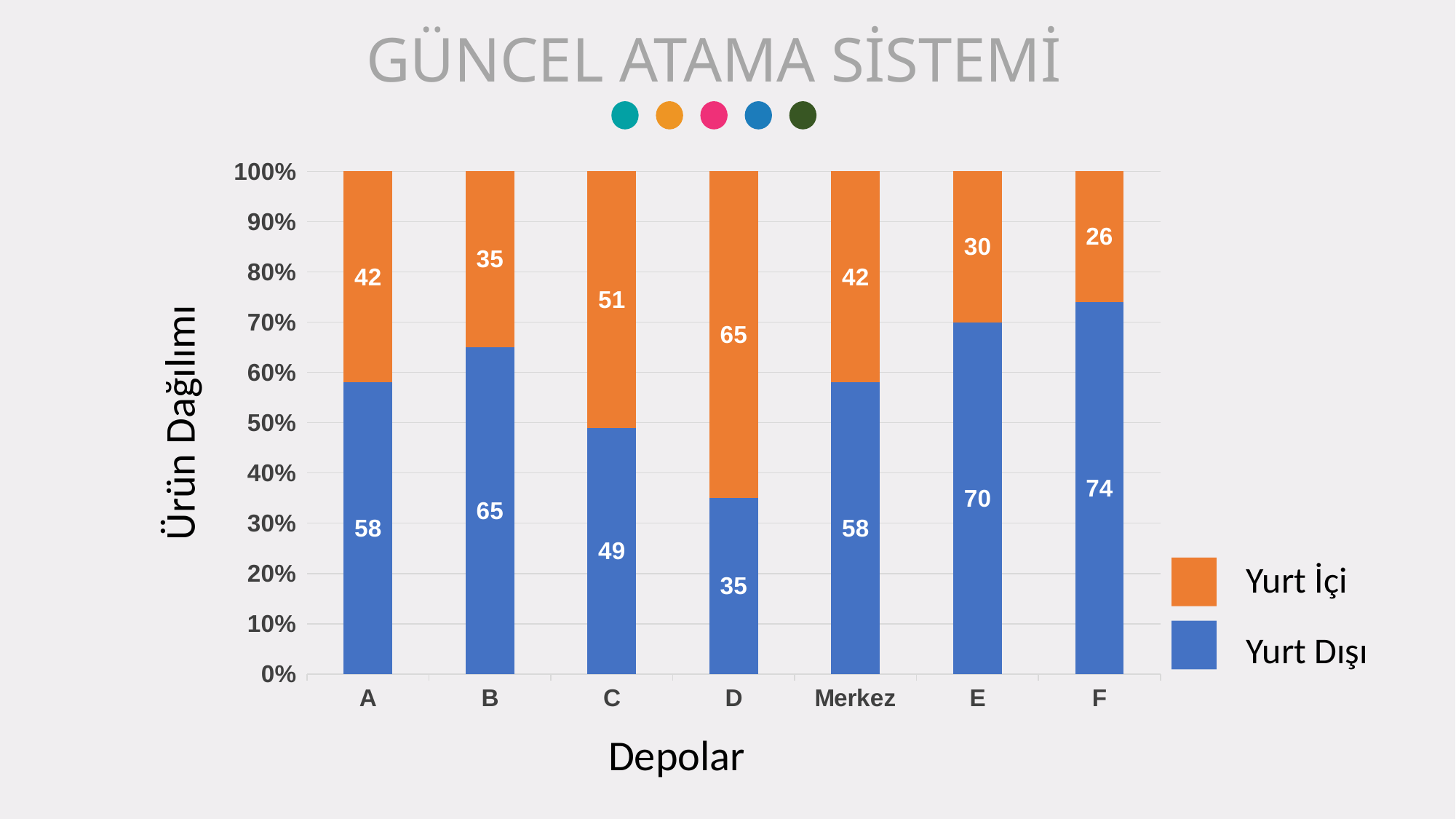
What is the Yurt Dışı value for depot D? 35 How many depots are shown on the x axis? 7 Which is larger, the Yurt İçi value for depot C or for depot B? C What is the Yurt İçi value for depot F? 26 What is the Yurt Dışı value for Merkez? 58 What kind of chart is shown on the slide? Stacked bar chart Which depot has the lowest Yurt İçi value? F What is the label of the x axis? Depolar What is the total of the two values in the bar for depot A? 100 What is the difference between the Yurt Dışı values for depots E and C? 21 How many series does the legend list? 2 Which depot has the highest Yurt Dışı value? F